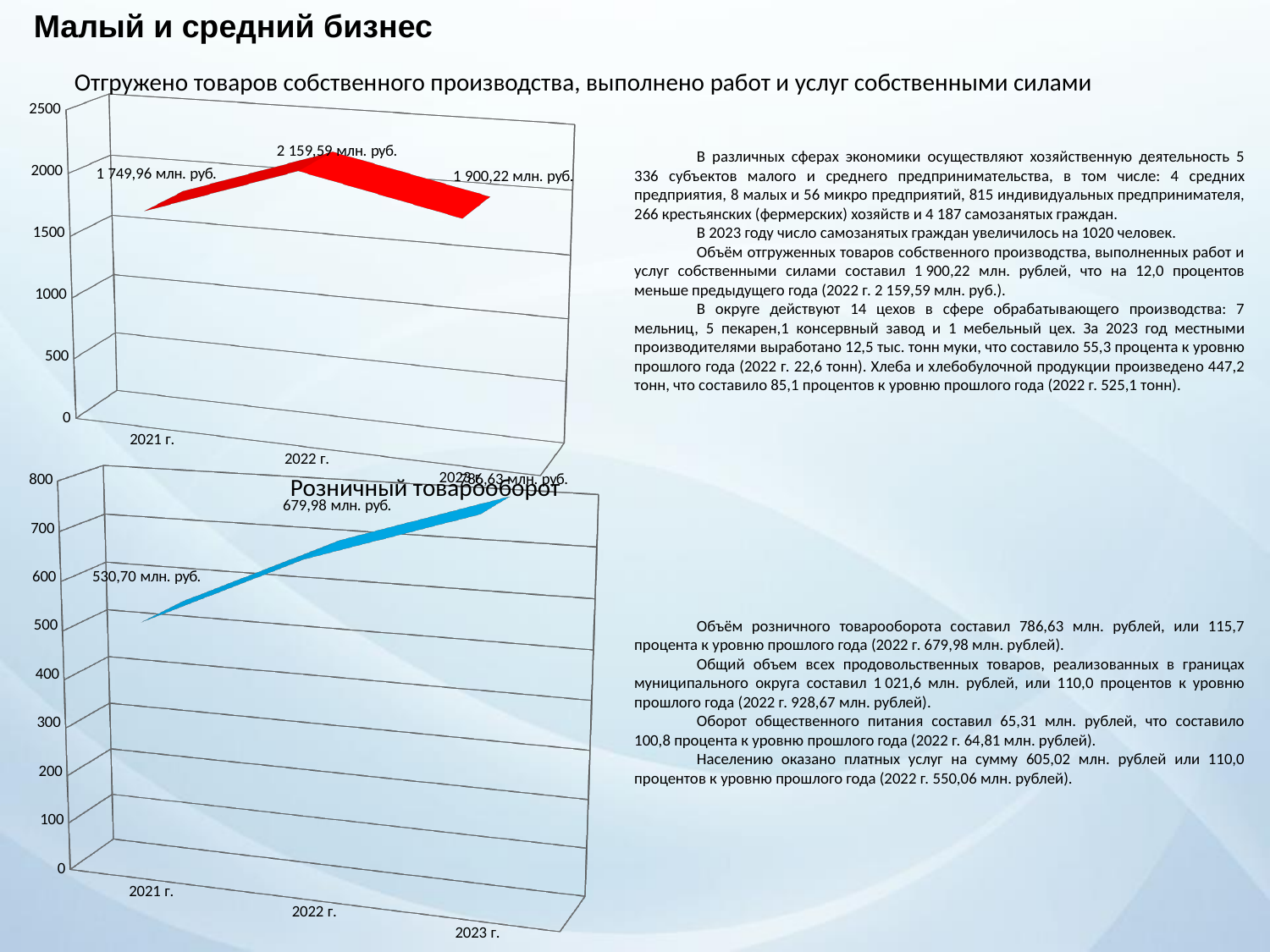
On the top chart (Отгружено товаров собственного производства), which year has the highest value? 2022 г. On the bottom chart (Розничный товарооборот), which is larger, the value for 2021 г. or for 2022 г.? 2022 г. On the bottom chart (Розничный товарооборот), what is the difference between the 2023 г. and 2022 г. values? 106,65 млн. руб. What kind of chart is the top chart (Отгружено товаров собственного производства)? line chart On the top chart (Отгружено товаров собственного производства), which year has the lowest value? 2021 г. On the top chart (Отгружено товаров собственного производства), what is the value for 2021 г.? 1 749,96 млн. руб. On the top chart (Отгружено товаров собственного производства), by how much does the 2022 г. value exceed the 2023 г. value? 259,37 млн. руб. On the bottom chart (Розничный товарооборот), what is the value for 2023 г.? 786,63 млн. руб. How many years are plotted on the bottom chart (Розничный товарооборот)? 3 On the top chart (Отгружено товаров собственного производства), what is the value for 2022 г.? 2 159,59 млн. руб. On the bottom chart (Розничный товарооборот), what is the value for 2021 г.? 530,70 млн. руб. On the bottom chart (Розничный товарооборот), do the values rise or fall from 2021 г. to 2023 г.? rise